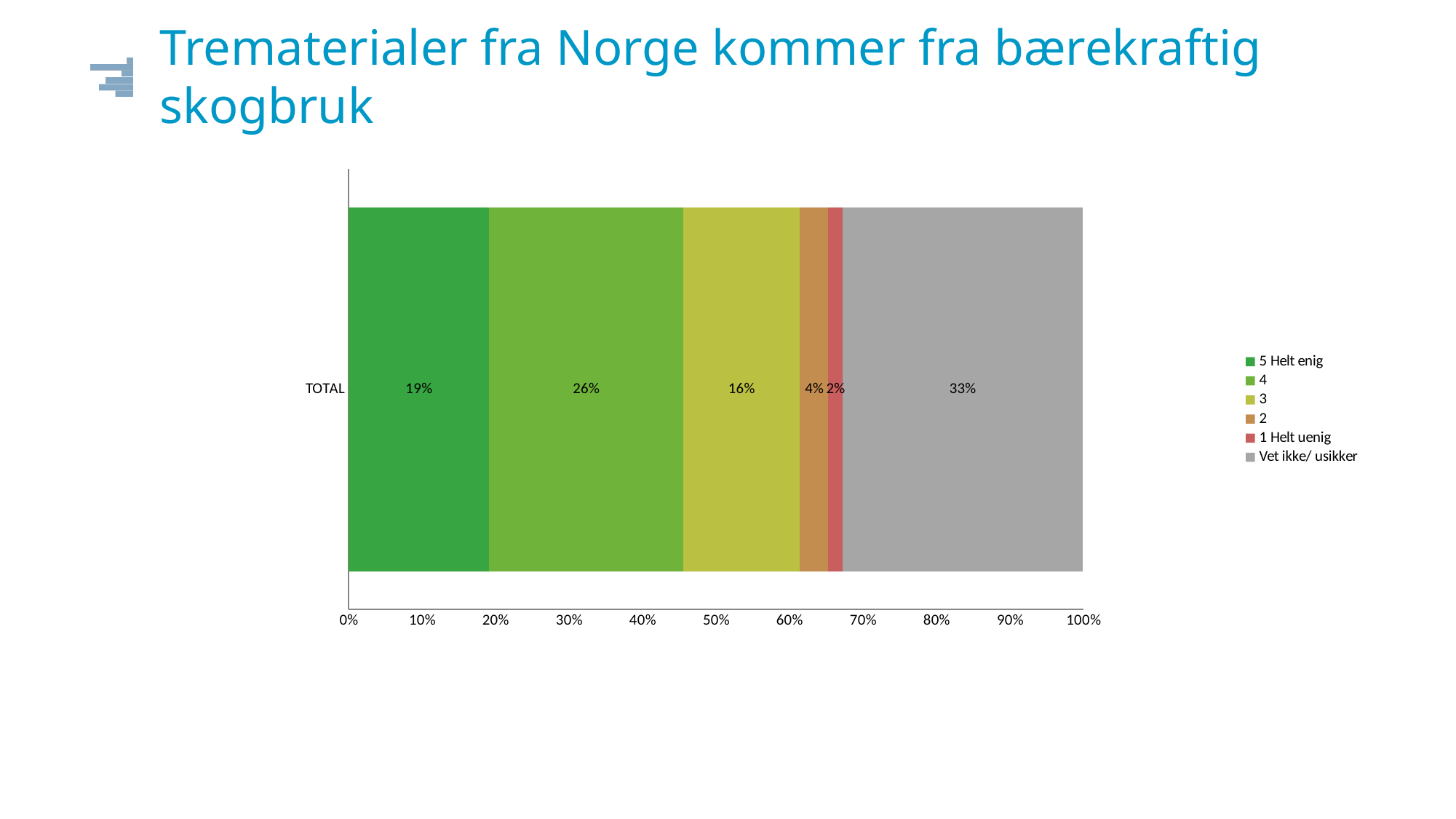
Which response category has the smallest share in the TOTAL bar? 1 Helt uenig What percentage of respondents answered '5 Helt enig'? 19% How many series does the legend list? 6 What is the difference between the '4' segment and the '3' segment? 10% What is the label of the single category on the vertical axis? TOTAL What is the value for '1 Helt uenig'? 2% Which is larger, the '5 Helt enig' segment or the '3' segment? 5 Helt enig What is the combined share of '5 Helt enig' and '4'? 45% What kind of chart is shown on the slide? Stacked bar chart What is the value for the '4' segment of the TOTAL bar? 26% Which response category has the largest share in the TOTAL bar? Vet ikke/ usikker What share of respondents answered 'Vet ikke/ usikker'? 33%